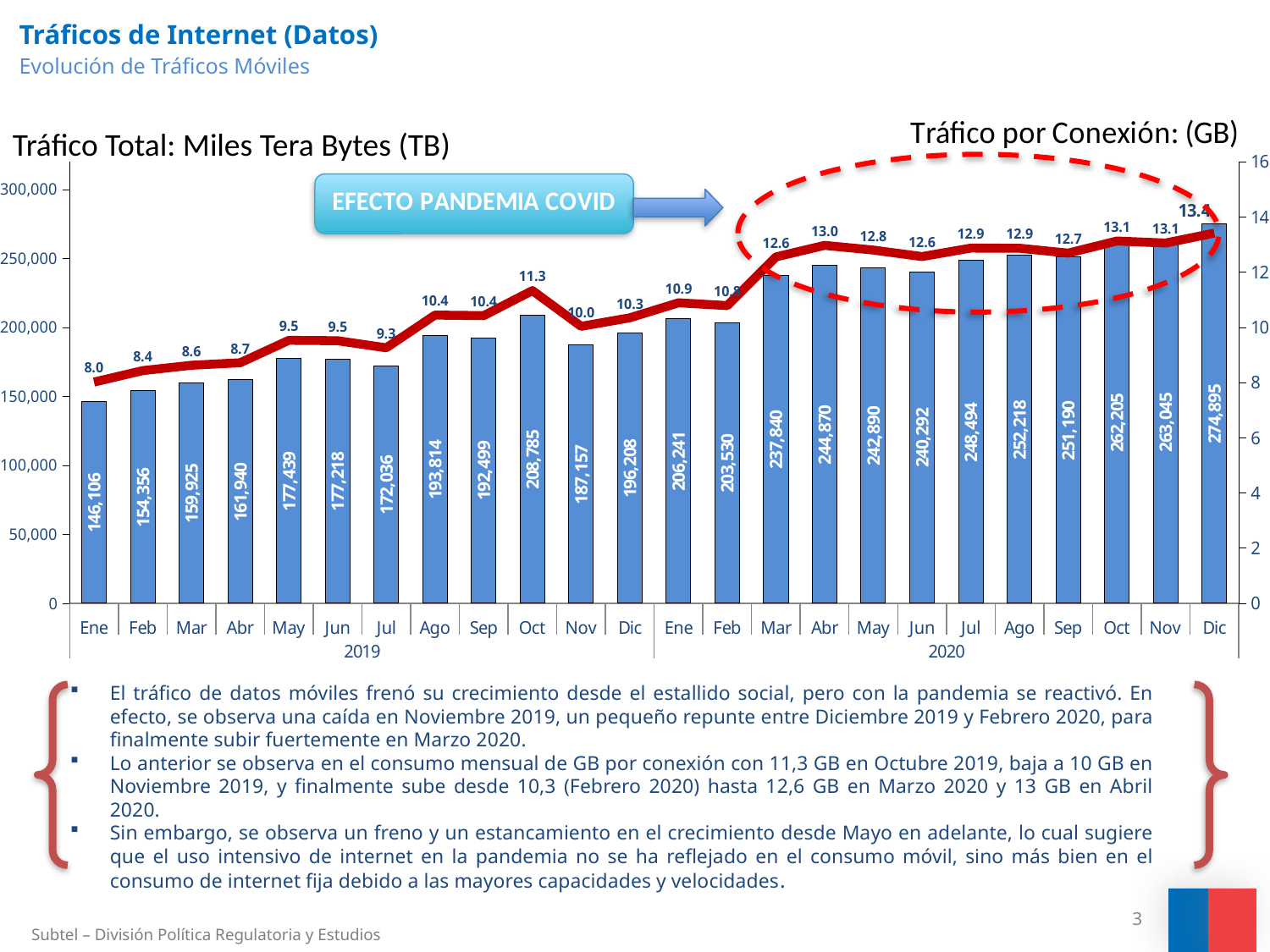
Which is larger, the total traffic bar for October 2019 or for November 2019? October 2019 What is the total mobile traffic (miles TB) for December 2020? 274,895 Does the total traffic generally rise or fall from January 2019 to December 2020? Rise What is the traffic per connection (GB) in April 2020? 13.0 What is the traffic per connection (GB) in October 2019? 11.3 Which month has the lowest total mobile traffic bar? Ene 2019 How many monthly bars are plotted in the chart? 24 What type of chart is used to show the total traffic (Tráfico Total)? Bar chart Which month has the highest total mobile traffic bar? Dic 2020 What is the difference in total traffic (miles TB) between March 2020 and February 2020? 34,310 What is the total mobile traffic (miles TB) for January 2019? 146,106 What text is shown in the callout box above the bars? EFECTO PANDEMIA COVID